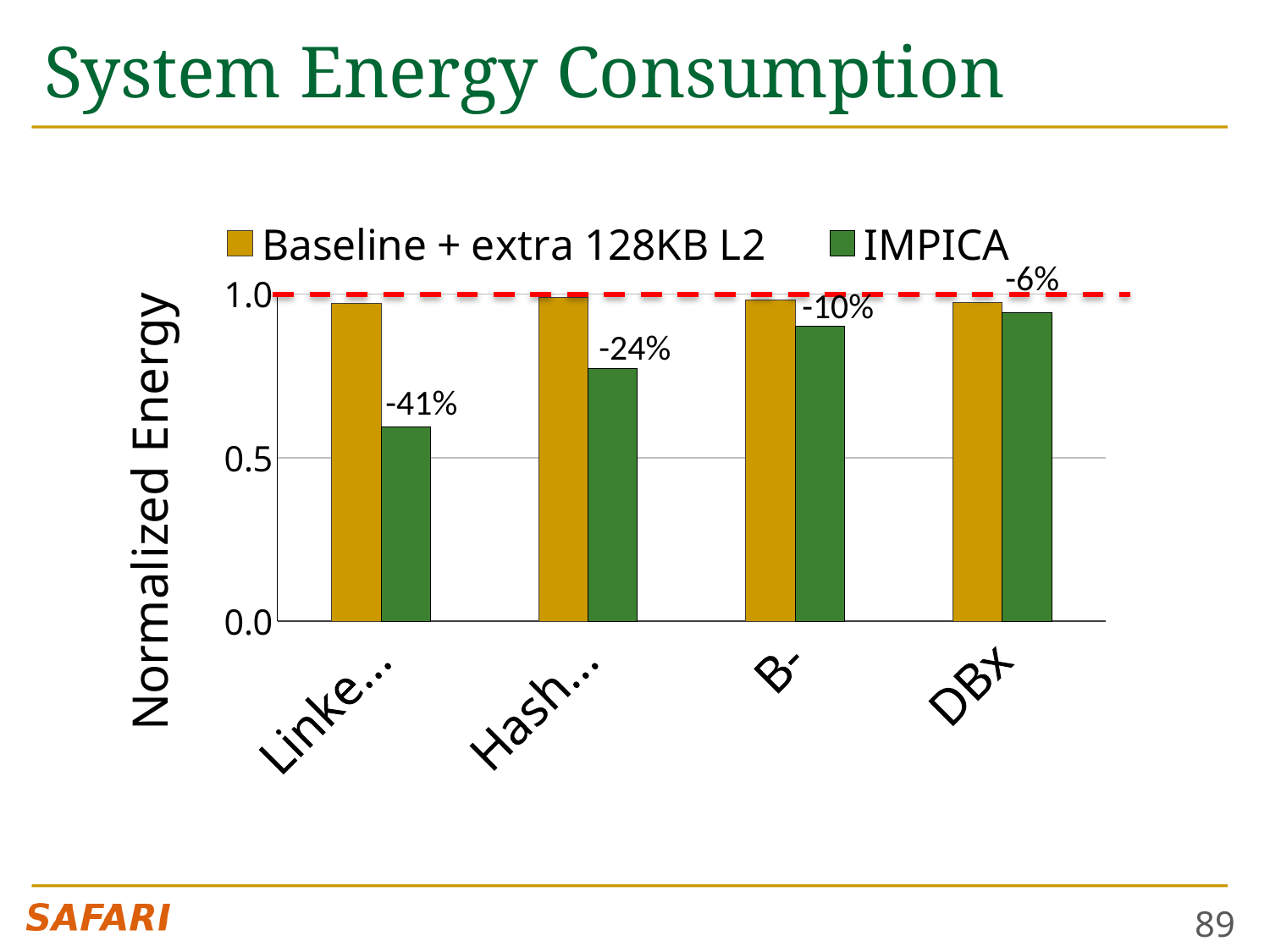
Which category has the highest IMPICA bar? DBx What percentage label is printed above the IMPICA bar for B-? -10% What are the two series named in the legend? Baseline + extra 128KB L2 and IMPICA What kind of chart is shown on the slide? bar chart Is the IMPICA value for B- greater or less than 0.5? greater How many series does the legend list? 2 At what y-axis value is the red dashed horizontal line drawn? 1.0 Is the IMPICA value for DBx greater or less than 0.5? greater How many categories are shown along the x axis? 4 For B-, which series has the larger bar, Baseline + extra 128KB L2 or IMPICA? Baseline + extra 128KB L2 What percentage label is printed above the IMPICA bar for DBx? -6% What is the label of the y axis? Normalized Energy